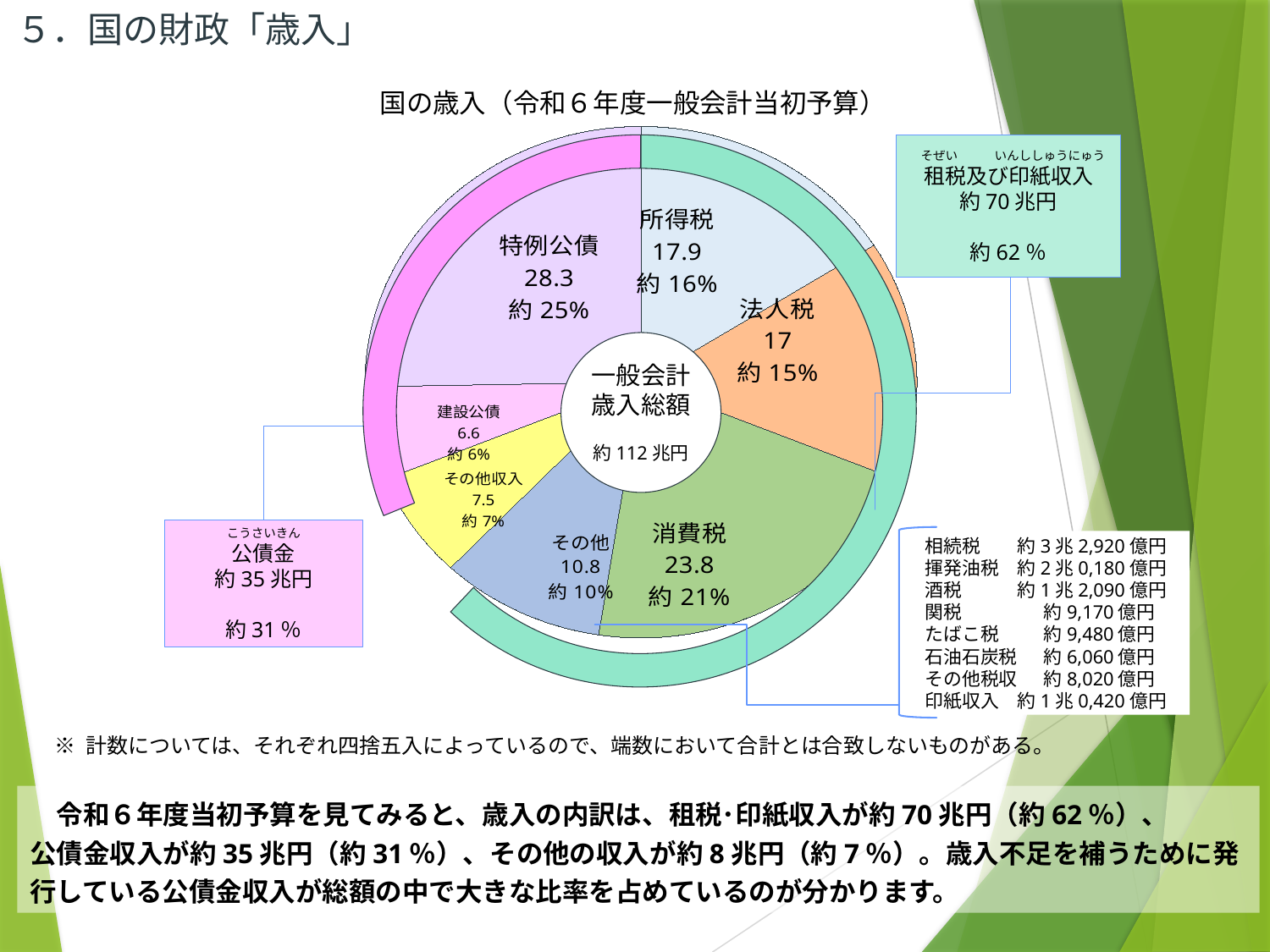
所得税の値はいくらですか？ 17.9 消費税は全体の何％を占めていますか？ 約21% 円グラフの中で最も値が小さい項目はどれですか？ 建設公債 特例公債の値はいくらですか？ 28.3 円グラフの中で最も値が大きい項目はどれですか？ 特例公債 グラフのタイトルは何ですか？ 国の歳入（令和６年度一般会計当初予算） 所得税と法人税では、どちらの値が大きいですか？ 所得税 このスライドのグラフはどの種類のグラフですか？ 円グラフ 消費税の値はいくらですか？ 23.8 円グラフには項目がいくつありますか？ 7 消費税と法人税の値の差はいくらですか？ 6.8 一般会計歳入総額はいくらですか？ 約112兆円